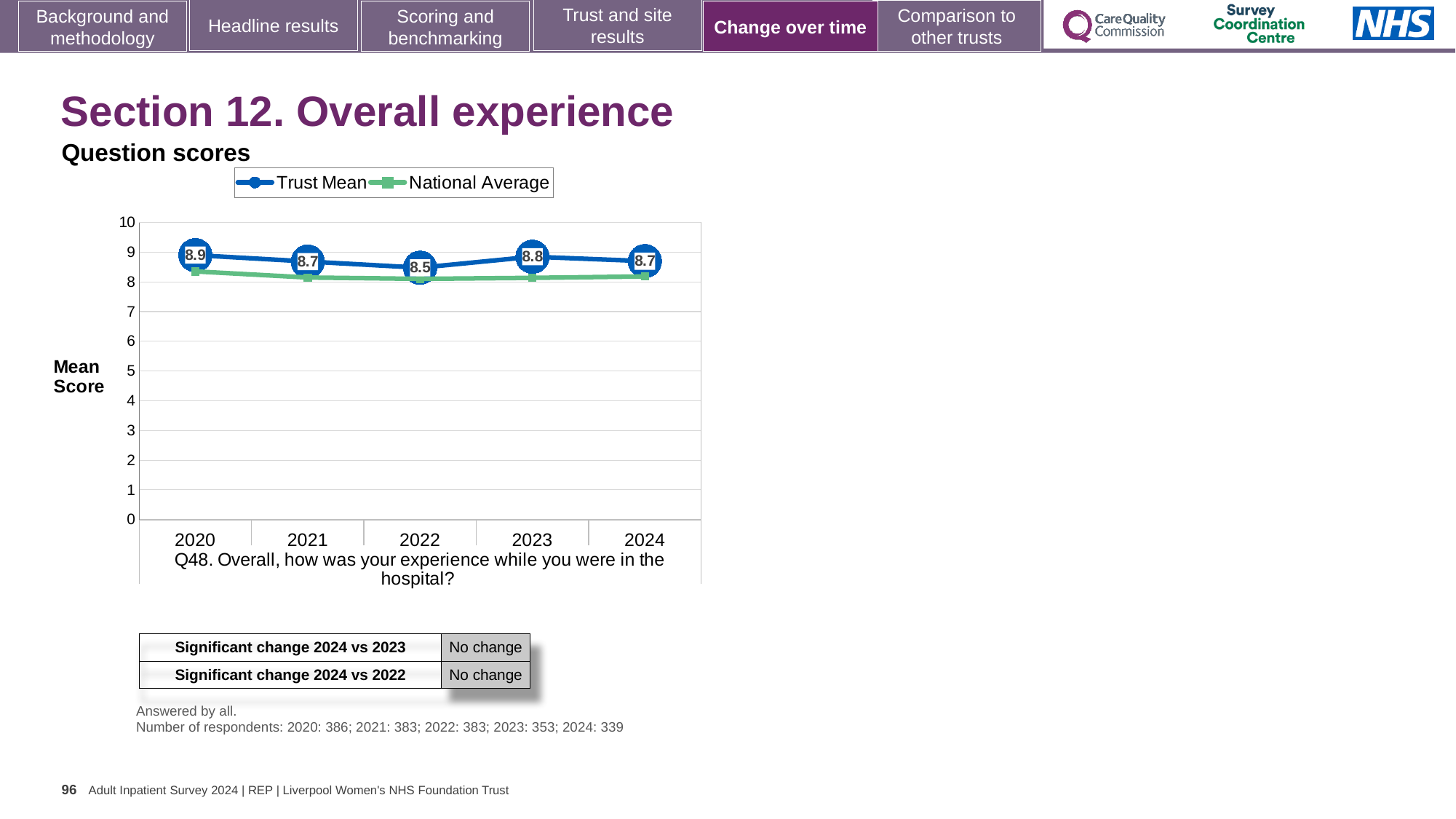
Is the National Average value for 2020 greater or less than 9? less Which is larger, the Trust Mean in 2023 or in 2022? 2023 What is the Trust Mean score for 2020? 8.9 In which year is the Trust Mean highest? 2020 What is the Trust Mean score for 2024? 8.7 How many series does the legend list? 2 In which year is the Trust Mean lowest? 2022 What kind of chart is shown? Line chart What is the difference between the Trust Mean in 2020 and in 2022? 0.4 Does the Trust Mean rise or fall from 2020 to 2022? Fall What is the Trust Mean score for 2022? 8.5 How many years are plotted on the x axis? 5